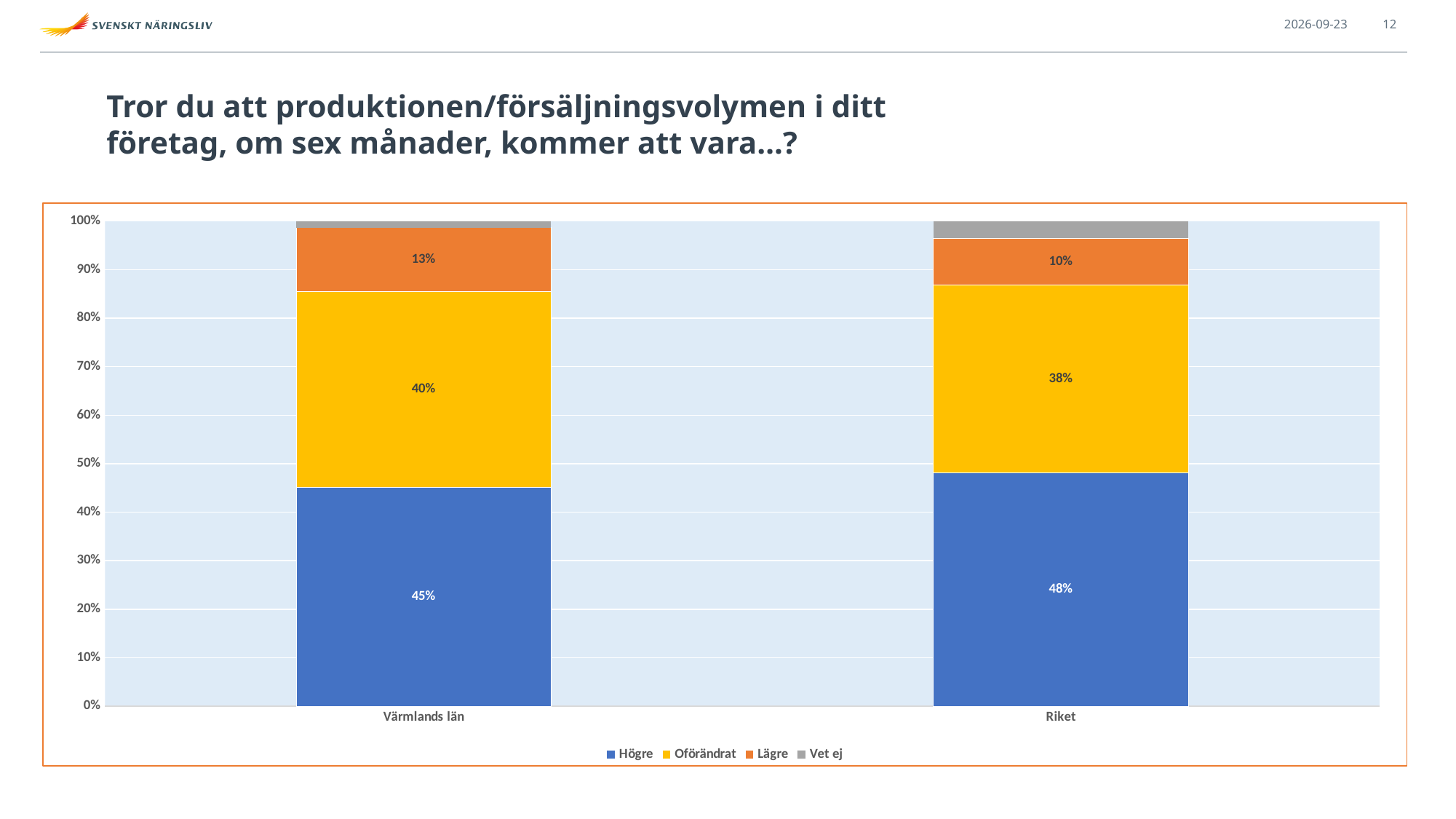
What is the difference in percentage points between the Oförändrat share in Värmlands län and in Riket? 2 percentage points What is the value for Lägre in Riket? 10% What percentage of respondents in Riket answered Oförändrat? 38% What percentage of respondents in Värmlands län answered Högre? 45% How many categories are shown on the x axis? 2 Which answer option has the largest share in Riket? Högre What kind of chart is shown on the slide? Stacked bar chart Which is larger: the Högre share in Värmlands län or in Riket? Riket What is the value for Lägre in Värmlands län? 13% Is the Vet ej share for Riket greater or less than 10%? less Which colour represents Oförändrat in the chart? Yellow How many series does the legend list? 4